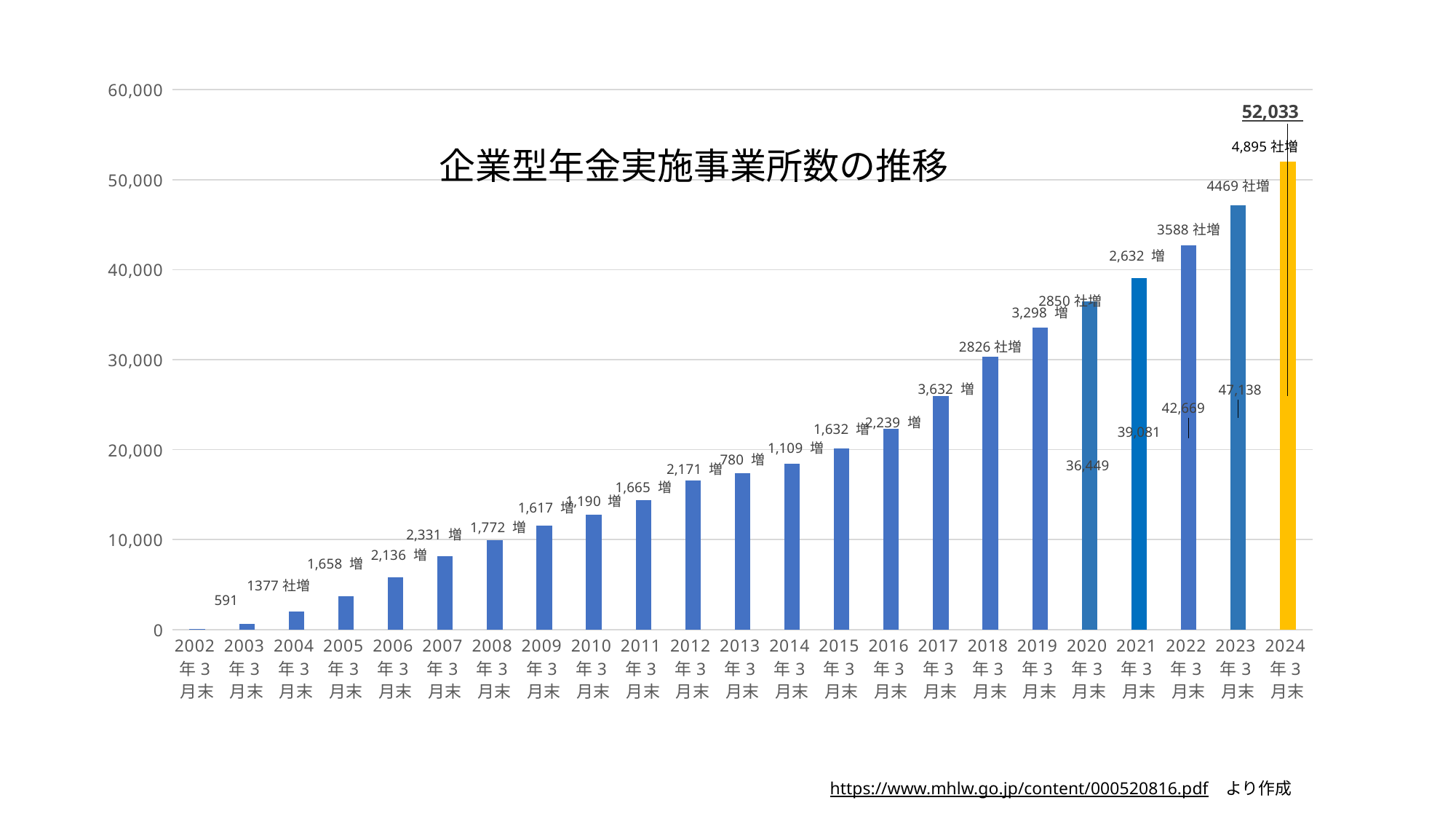
What is the difference between the values for 2024年3月末 and 2023年3月末? 4,895 Which category has the lowest value? 2002年3月末 What is the value for 2020年3月末? 36,449 What kind of chart is shown on the slide? Bar chart Do the values rise or fall from 2002 to 2024 along the x axis? Rise Which category has the highest value? 2024年3月末 Is the value for 2019年3月末 greater or less than 30,000? greater What is the title of the chart? 企業型年金実施事業所数の推移 What is the value for 2023年3月末? 47,138 How many categories (years) are plotted on the x axis? 23 What is the value for 2024年3月末? 52,033 What is the difference between the values for 2022年3月末 and 2021年3月末? 3,588